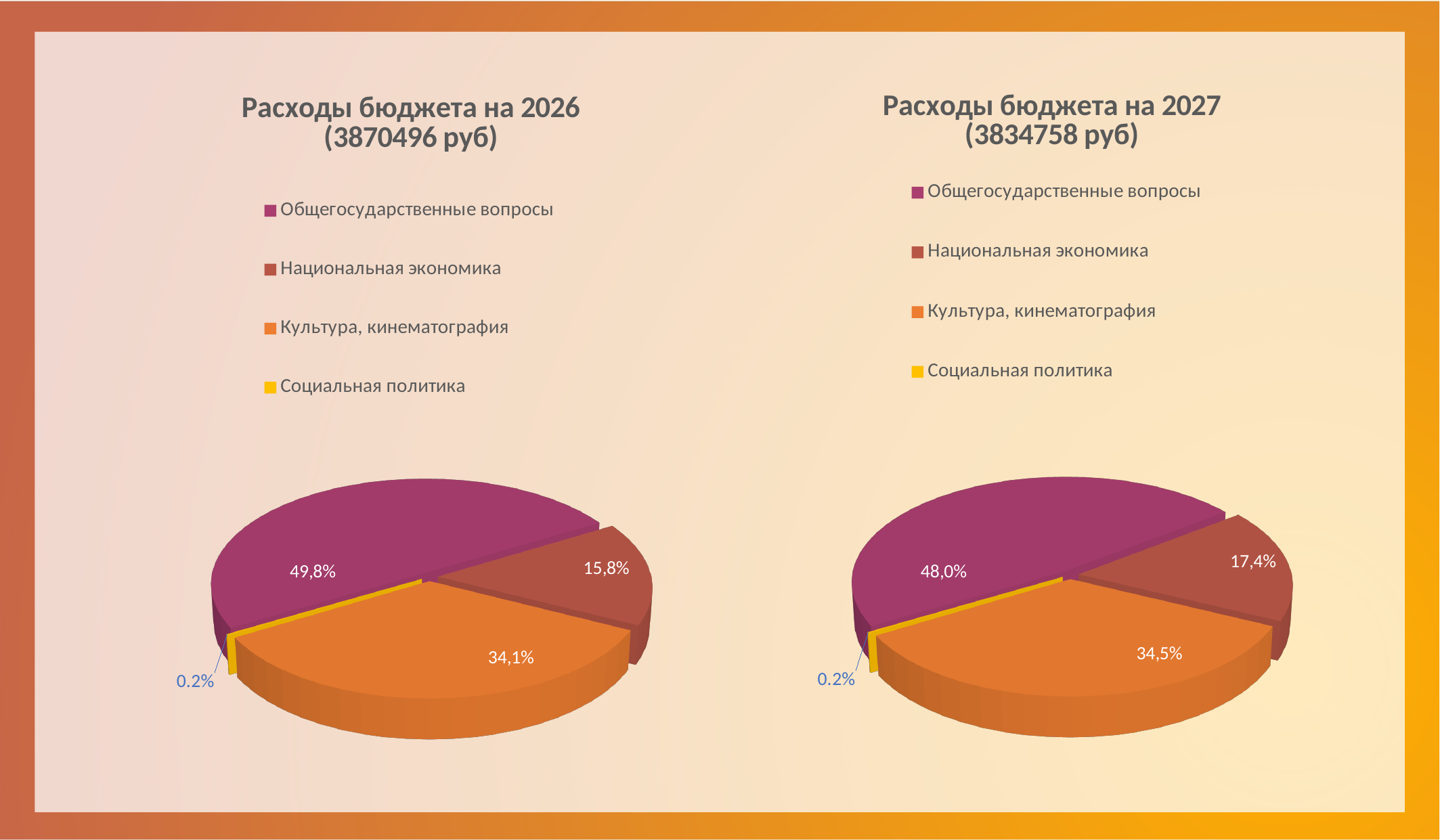
What total budget amount is shown in the title of the right chart for 2027? 3834758 руб In the right chart 'Расходы бюджета на 2027', what share does 'Национальная экономика' have? 17,4% In the left chart 'Расходы бюджета на 2026', which category has the smallest share? Социальная политика In the right chart 'Расходы бюджета на 2027', what share does 'Социальная политика' have? 0.2% What kind of chart is the left chart, 'Расходы бюджета на 2026'? pie chart In the left chart 'Расходы бюджета на 2026', what share does 'Культура, кинематография' have? 34,1% How many categories does the legend of the left chart 'Расходы бюджета на 2026' list? 4 In the left chart 'Расходы бюджета на 2026', what share does 'Общегосударственные вопросы' have? 49,8% In the right chart 'Расходы бюджета на 2027', what share does 'Общегосударственные вопросы' have? 48,0% In the left chart 'Расходы бюджета на 2026', what share does 'Национальная экономика' have? 15,8% In the right chart 'Расходы бюджета на 2027', what is the difference between the shares of 'Культура, кинематография' and 'Национальная экономика'? 17,1% In the right chart 'Расходы бюджета на 2027', which category has the largest share? Общегосударственные вопросы